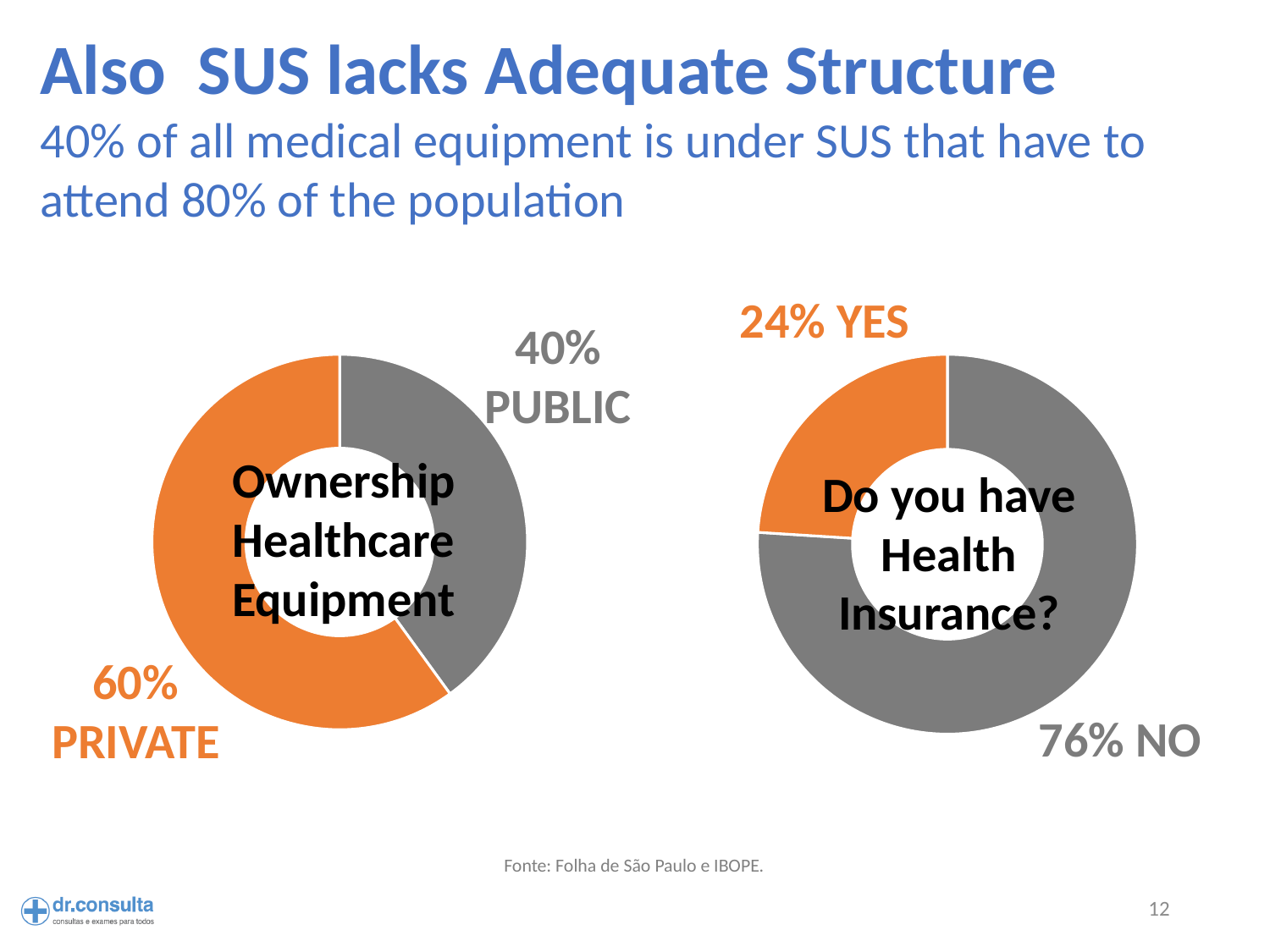
In the 'Ownership Healthcare Equipment' chart, what is the difference between the PRIVATE and PUBLIC shares? 20% Is the PUBLIC share in the 'Ownership Healthcare Equipment' chart larger or smaller than the NO share in the 'Do you have Health Insurance?' chart? smaller In the 'Do you have Health Insurance?' chart, what share answered YES? 24% In the 'Ownership Healthcare Equipment' chart, what share is PUBLIC? 40% How many categories does the 'Do you have Health Insurance?' chart show? 2 What kind of chart is the 'Ownership Healthcare Equipment' chart? Doughnut (pie) chart In the 'Do you have Health Insurance?' chart, what colour is the YES slice? Orange In the 'Ownership Healthcare Equipment' chart, what share is PRIVATE? 60% In the 'Do you have Health Insurance?' chart, which answer has the smaller share? YES In the 'Ownership Healthcare Equipment' chart, which category has the larger share? PRIVATE In the 'Do you have Health Insurance?' chart, what share answered NO? 76% In the 'Do you have Health Insurance?' chart, what is the difference between the NO and YES shares? 52%